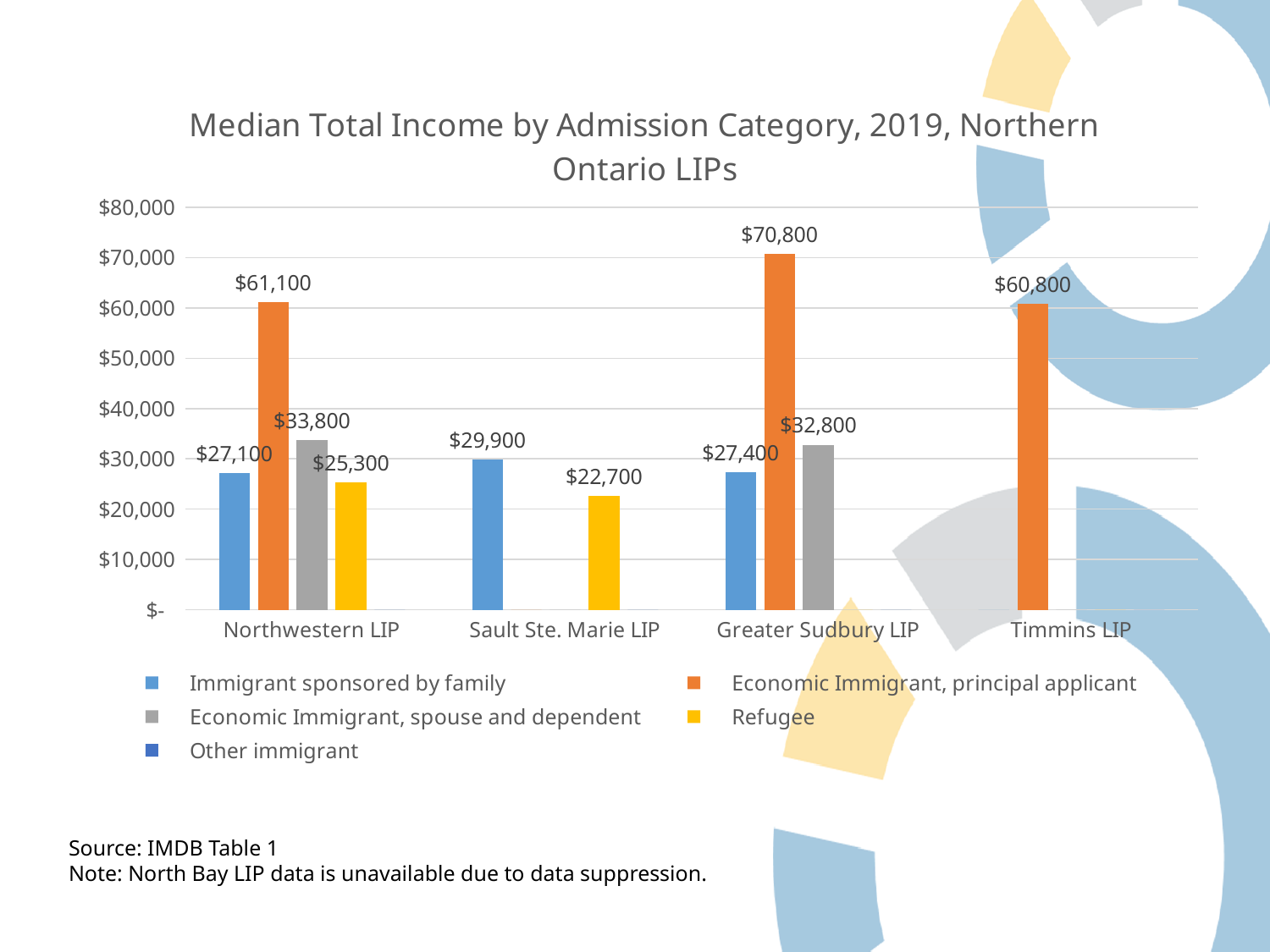
Which LIP has the highest median total income for Economic Immigrant, principal applicant? Greater Sudbury LIP How many series does the legend list? 5 What is the difference between the Immigrant sponsored by family and Refugee values for Northwestern LIP? $1,800 What is the median total income for Economic Immigrant, principal applicant in Timmins LIP? $60,800 Which LIP has the lowest median total income for Refugee among those shown? Sault Ste. Marie LIP What is the median total income for Immigrant sponsored by family in Northwestern LIP? $27,100 What is the median total income for Economic Immigrant, principal applicant in Greater Sudbury LIP? $70,800 How many LIPs are shown on the x axis of the chart? 4 What type of chart is shown on the slide? Bar chart What is the difference between the Economic Immigrant, principal applicant values for Greater Sudbury LIP and Timmins LIP? $10,000 Which LIP has the larger value for Economic Immigrant, spouse and dependent: Northwestern LIP or Greater Sudbury LIP? Northwestern LIP What is the median total income for Refugee in Sault Ste. Marie LIP? $22,700